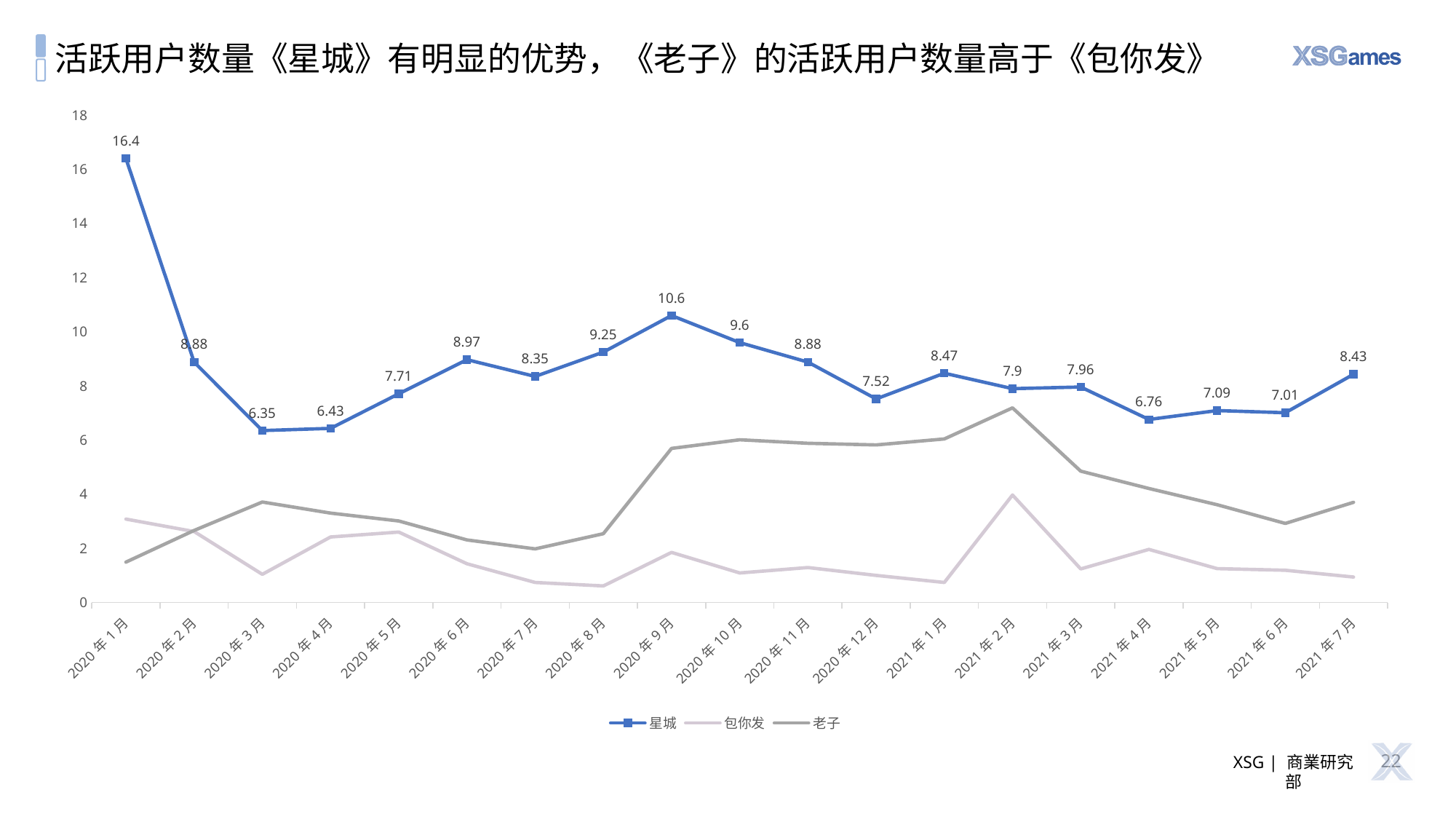
How many months are plotted along the x axis? 19 What is the difference between the 星城 values for 2020年1月 and 2020年2月? 7.52 What is the value for 星城 in 2020年9月? 10.6 How many series does the legend list? 3 What kind of chart is shown on the slide? line chart Does the 星城 line rise or fall from 2020年1月 to 2020年3月? fall In which month does 星城 reach its lowest value? 2020年3月 Is the value for 老子 in 2021年2月 greater or less than 6? greater In which month does 星城 reach its highest value? 2020年1月 Is the value for 包你发 in 2020年3月 greater or less than 2? less What is the value for 星城 in 2020年1月? 16.4 For 星城, which month has the larger value: 2020年8月 or 2020年10月? 2020年10月